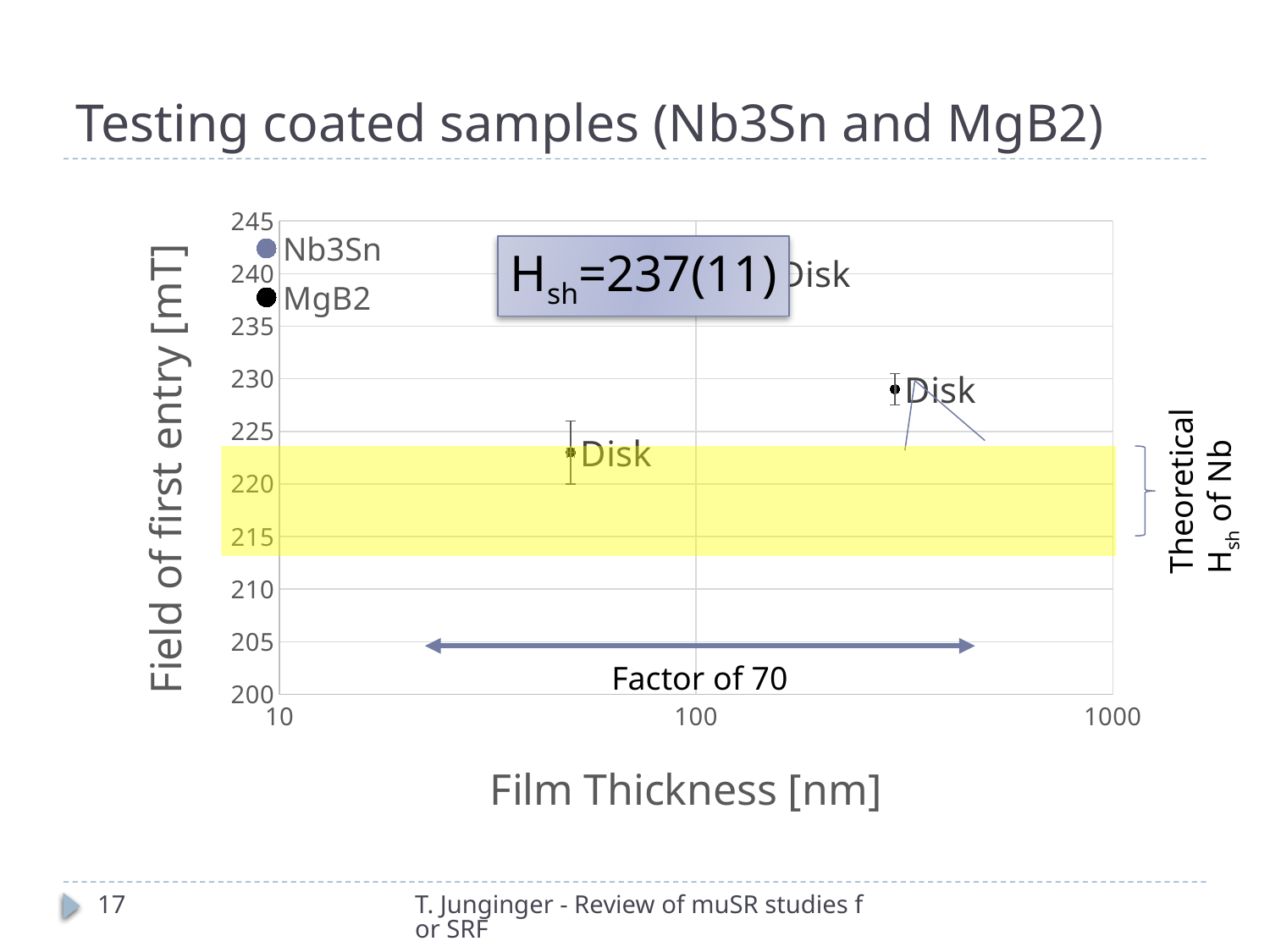
Is the field of first entry for the Disk point at about 50 nm film thickness greater or less than 225? less Is the field of first entry for the Disk point at about 50 nm film thickness greater or less than 220? greater Is the field of first entry for the Disk point at about 300 nm film thickness greater or less than 210? greater What is the title of the x axis of the chart? Film Thickness [nm] Which has the higher field of first entry: the Disk point at about 50 nm or the Disk point at about 300 nm film thickness? the Disk point at about 300 nm What kind of chart is shown on the slide? scatter chart What are the two series named in the chart legend? Nb3Sn and MgB2 How many series does the chart legend list? 2